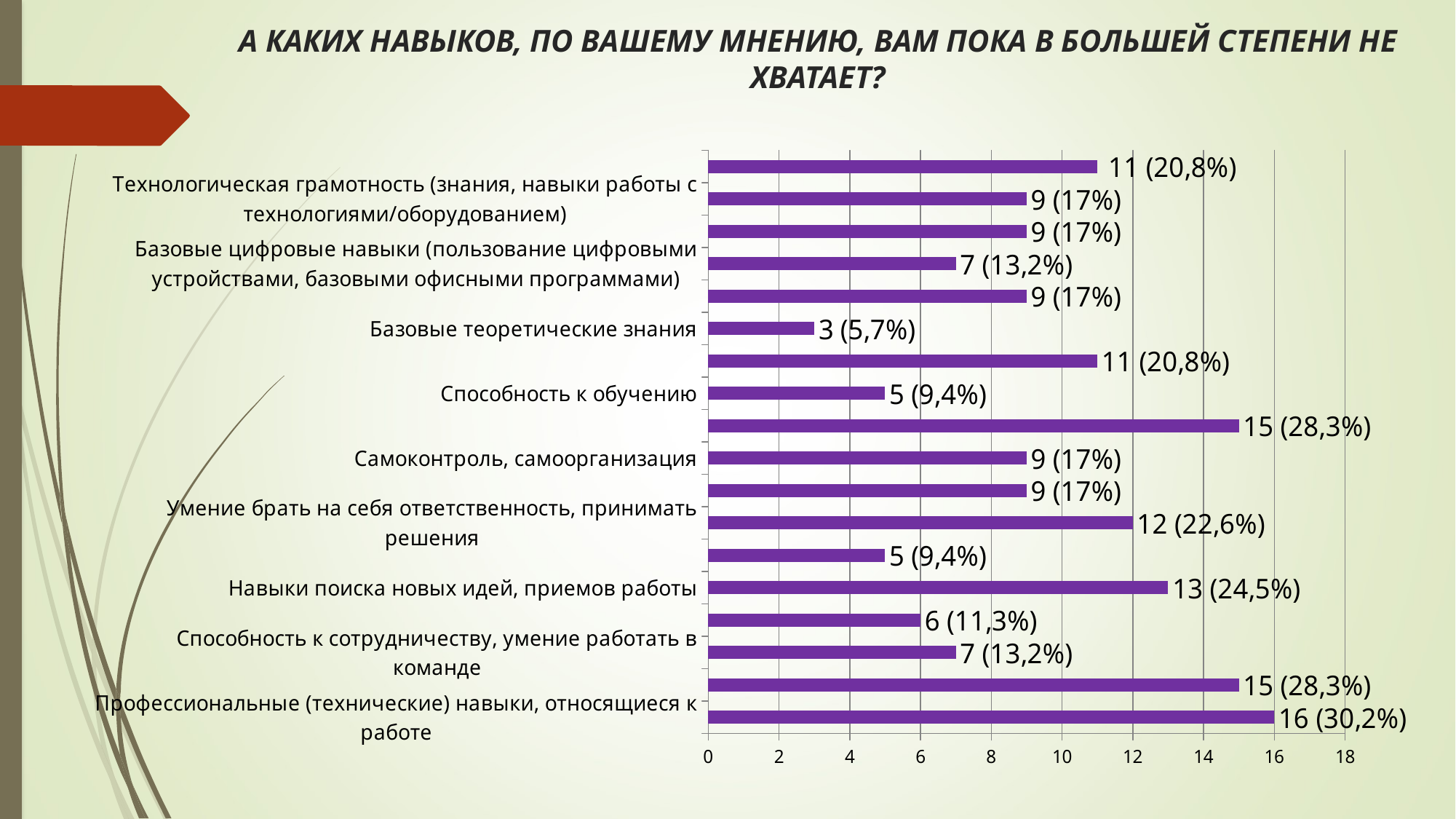
What is the difference between the value for "Профессиональные (технические) навыки, относящиеся к работе" (16) and "Базовые теоретические знания" (3)? 13 What value is shown for "Базовые теоретические знания"? 3 (5,7%) What is the smallest value shown on the chart? 3 (5,7%) What value is shown for "Профессиональные (технические) навыки, относящиеся к работе"? 16 (30,2%) What value is shown for "Способность к обучению"? 5 (9,4%) What is the largest value shown on the chart? 16 (30,2%) What kind of chart is shown on the slide? bar chart What value is shown for "Самоконтроль, самоорганизация"? 9 (17%) How many bars are plotted on the chart? 18 What value is shown for "Навыки поиска новых идей, приемов работы"? 13 (24,5%) What is the highest tick value shown on the horizontal axis? 18 Which is larger: the value for "Навыки поиска новых идей, приемов работы" or for "Способность к обучению"? Навыки поиска новых идей, приемов работы